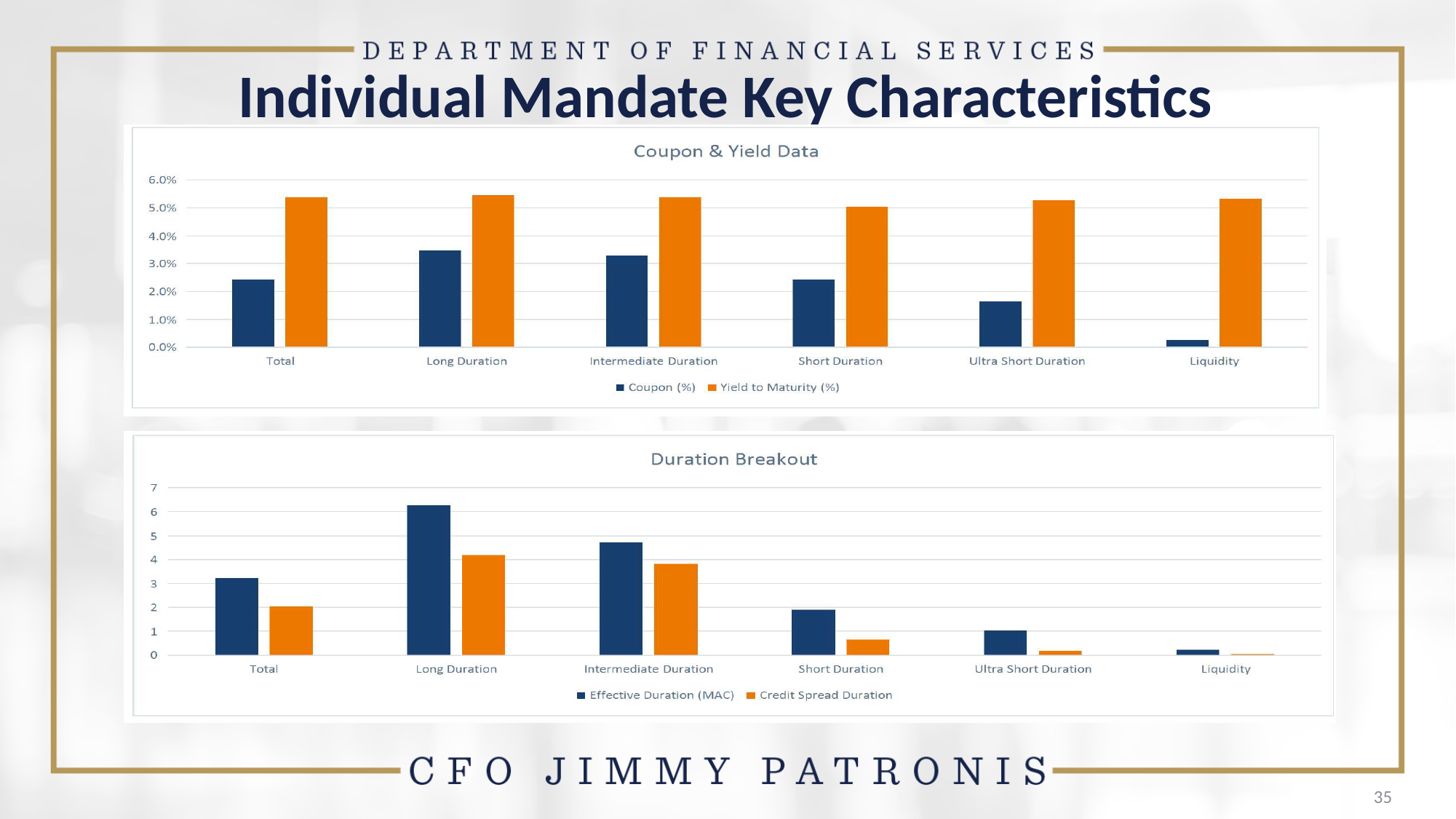
How many categories are shown on the x axis of the Duration Breakout chart? 6 In the Duration Breakout chart, which category has the lowest Credit Spread Duration? Liquidity In the Duration Breakout chart, which category has the highest Effective Duration (MAC)? Long Duration In the Coupon & Yield Data chart, is the Coupon (%) value for Long Duration greater or less than 3.0%? greater In the Duration Breakout chart, is the Effective Duration (MAC) for Long Duration greater or less than 6? greater In the Duration Breakout chart, is the Effective Duration (MAC) for Intermediate Duration greater or less than 4? greater In the Coupon & Yield Data chart, which is larger for Total: Coupon (%) or Yield to Maturity (%)? Yield to Maturity (%) What kind of chart is the Duration Breakout chart? Bar chart In the Coupon & Yield Data chart, which category has the lowest Yield to Maturity (%) value? Short Duration How many series does the legend of the Coupon & Yield Data chart list? 2 In the Coupon & Yield Data chart, which category has the lowest Coupon (%) value? Liquidity